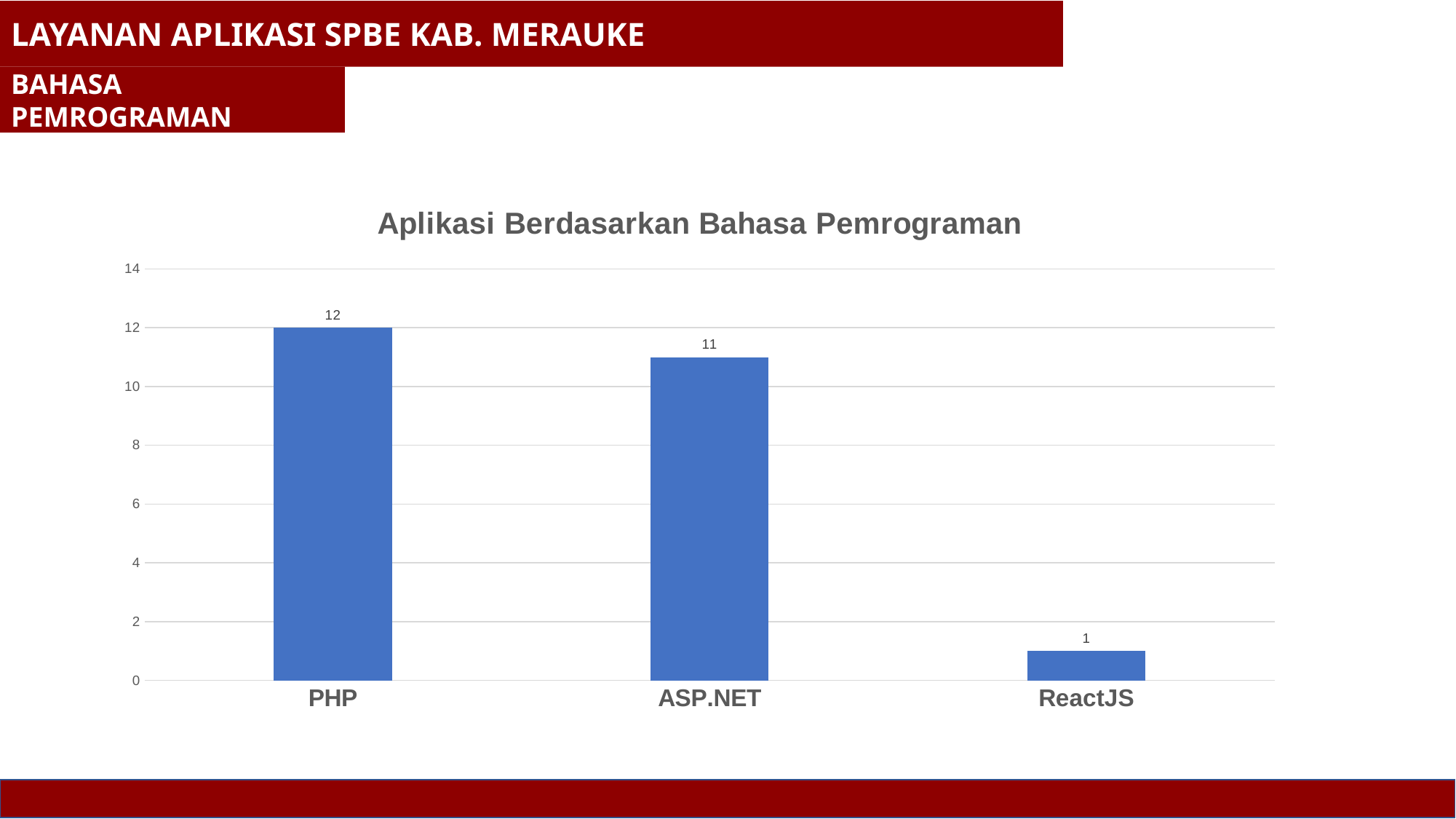
Which programming language has the highest number of applications? PHP What is the difference between the values for PHP and ReactJS? 11 What is the value for PHP? 12 What is the difference between the values for PHP and ASP.NET? 1 What is the value for ReactJS? 1 What kind of chart is shown on the slide? Bar chart How many programming languages are shown on the chart? 3 Is the value for ASP.NET greater or less than 10? greater Which is larger, the value for ASP.NET or the value for ReactJS? ASP.NET Which programming language has the lowest number of applications? ReactJS What is the title of the chart? Aplikasi Berdasarkan Bahasa Pemrograman What is the value for ASP.NET? 11